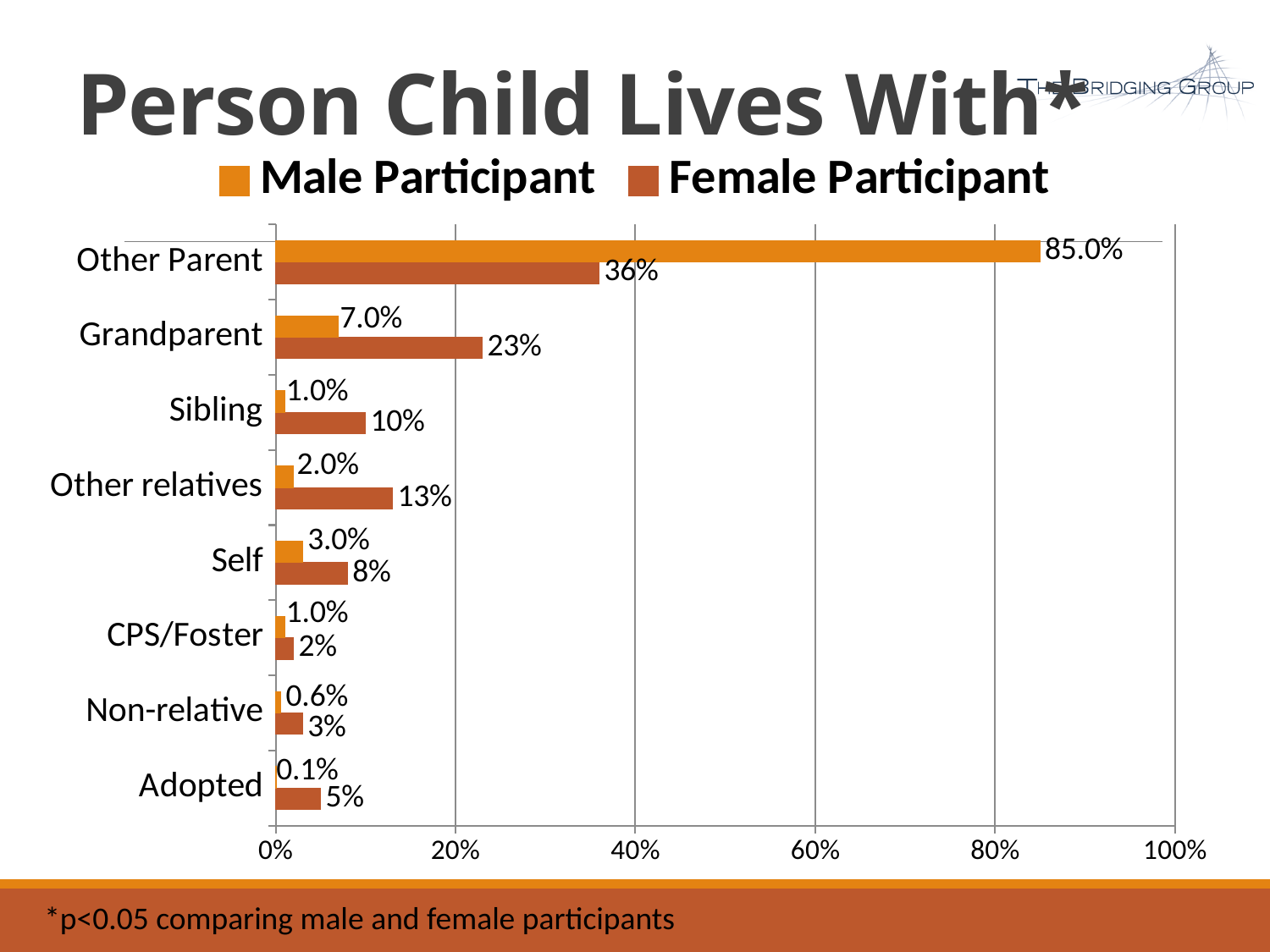
How many categories are shown on the chart? 8 What is the value for Male Participant in the Other Parent category? 85.0% What is the difference between the Male Participant and Female Participant values for Other Parent? 49.0% Which is larger for Other relatives: the Male Participant value or the Female Participant value? Female Participant Which category has the highest value for Female Participant? Other Parent What is the value for Female Participant in the Sibling category? 10% What kind of chart is shown on the slide? Bar chart What is the value for Female Participant in the Grandparent category? 23% What is the title of the chart? Person Child Lives With* Which category has the lowest value for Male Participant? Adopted What is the value for Male Participant in the Adopted category? 0.1% How many series does the legend list? 2